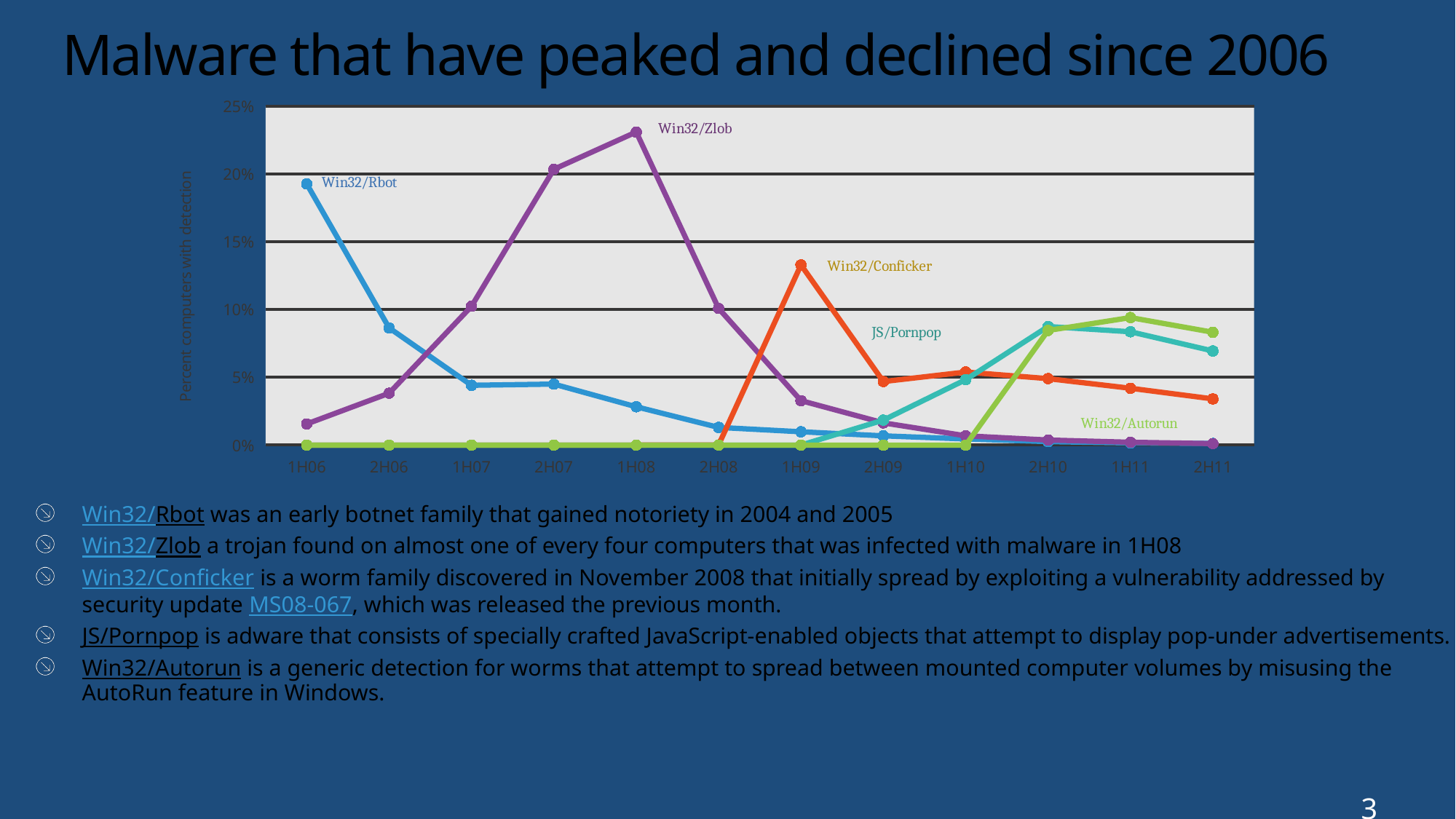
In which period does Win32/Conficker reach its peak? 1H09 Is the value for Win32/Conficker in 1H09 greater or less than 15%? less What kind of chart is shown on the slide? line chart How many time periods are shown on the x axis of the chart? 12 In 2H11, which is larger: JS/Pornpop or Win32/Conficker? JS/Pornpop How many malware families are plotted as lines on the chart? 5 In which period does Win32/Zlob reach its peak? 1H08 What is the title of the chart's y axis? Percent computers with detection Is the value for Win32/Rbot in 1H06 greater or less than 15%? greater Which malware family reaches the highest value on the chart? Win32/Zlob Is the value for Win32/Zlob in 1H08 greater or less than 20%? greater Does the Win32/Rbot line rise or fall from 1H06 to 2H11? fall